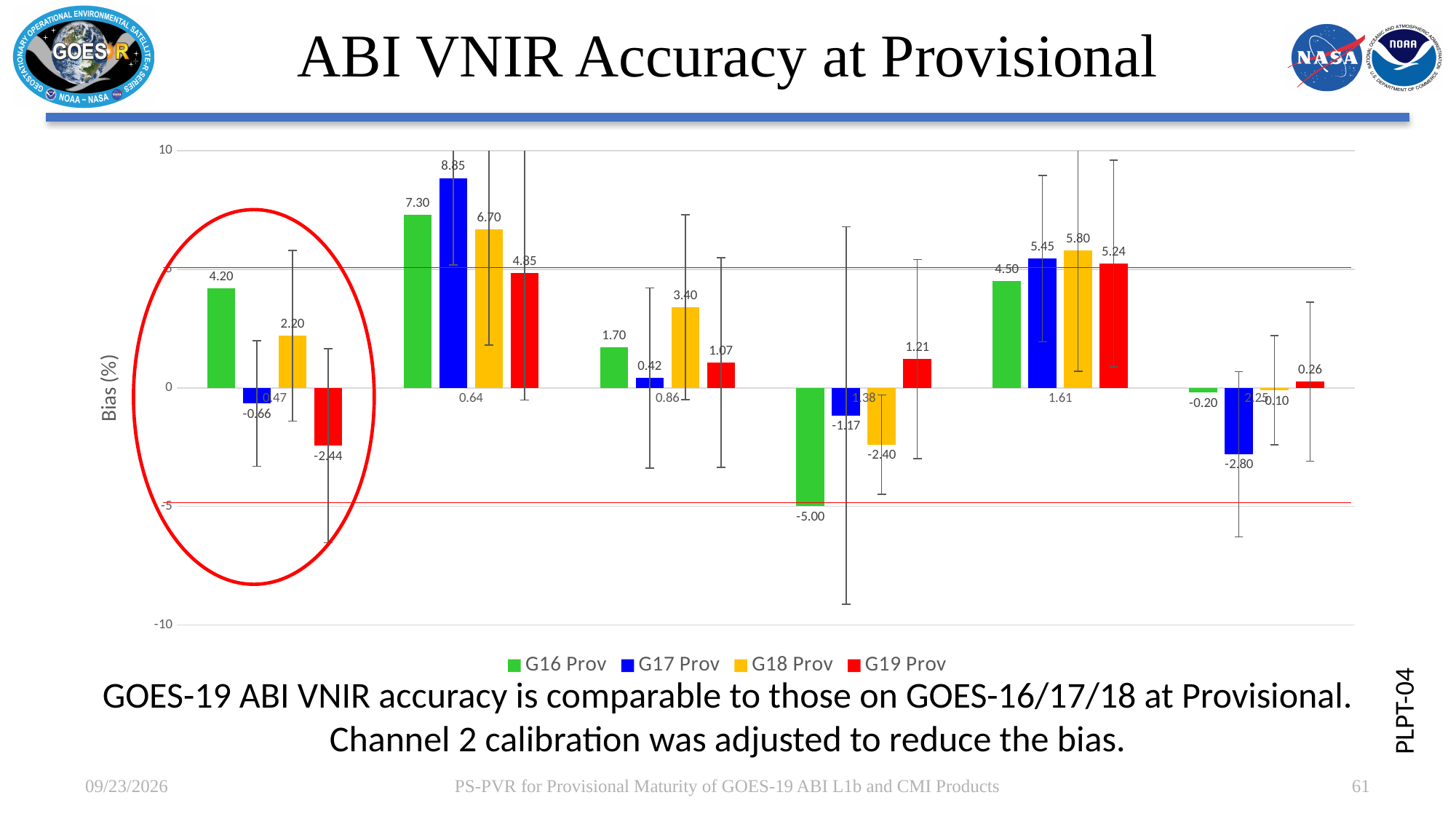
How many series does the legend list? 4 Which series has the highest value in the second group of bars? G17 Prov In the third group of bars, which is larger: the G18 Prov value or the G16 Prov value? G18 Prov How many groups of bars are plotted along the x axis? 6 What is the label on the vertical axis? Bias (%) What kind of chart is shown on the slide? bar chart What is the G19 Prov value in the first (circled) group of bars? -2.44 What is the difference between the G16 Prov value (7.30) and the G19 Prov value (4.85) in the second group of bars? 2.45 What is the G16 Prov value in the first (circled) group of bars? 4.20 What is the lowest value plotted on the chart? -5.00 Which series is shown in red in the legend? G19 Prov What is the G18 Prov value in the fifth group of bars? 5.80